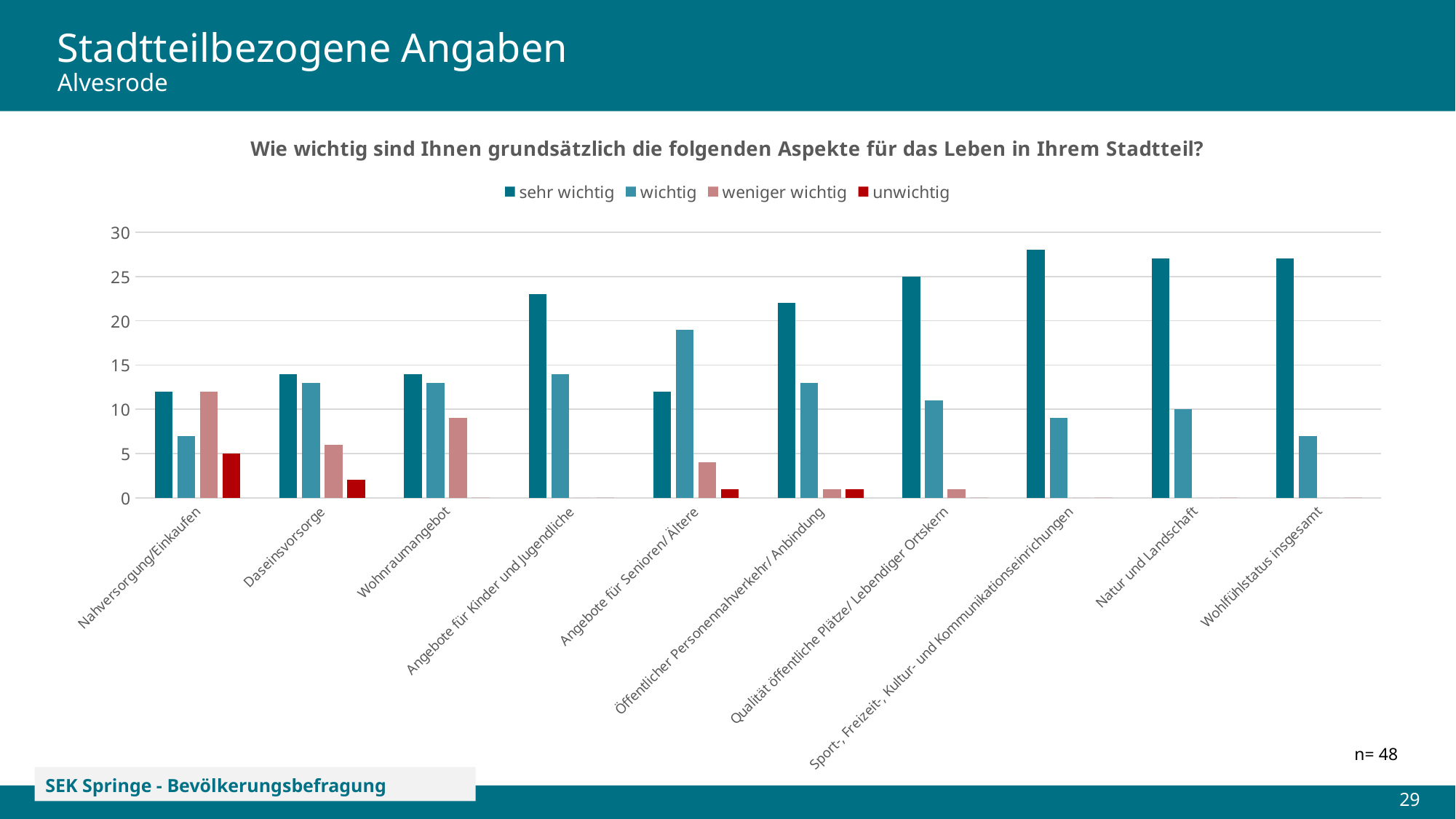
Which category has the highest value for 'wichtig'? Angebote für Senioren/ Ältere What is the value of 'wichtig' for 'Natur und Landschaft'? 10 How many series does the legend list? 4 How many categories are shown on the x axis? 10 What colour represents the series 'unwichtig' in the legend? red Is the value of 'wichtig' for 'Angebote für Senioren/ Ältere' greater or less than 15? greater For 'Wohlfühlstatus insgesamt', which is larger: 'sehr wichtig' or 'wichtig'? sehr wichtig What kind of chart is shown on the slide? bar chart Is the value of 'sehr wichtig' for 'Sport-, Freizeit-, Kultur- und Kommunikationseinrichtungen' greater or less than 25? greater Which category has the highest value for 'weniger wichtig'? Nahversorgung/Einkaufen What is the value of 'unwichtig' for 'Nahversorgung/Einkaufen'? 5 What is the value of 'sehr wichtig' for 'Qualität öffentliche Plätze/ Lebendiger Ortskern'? 25